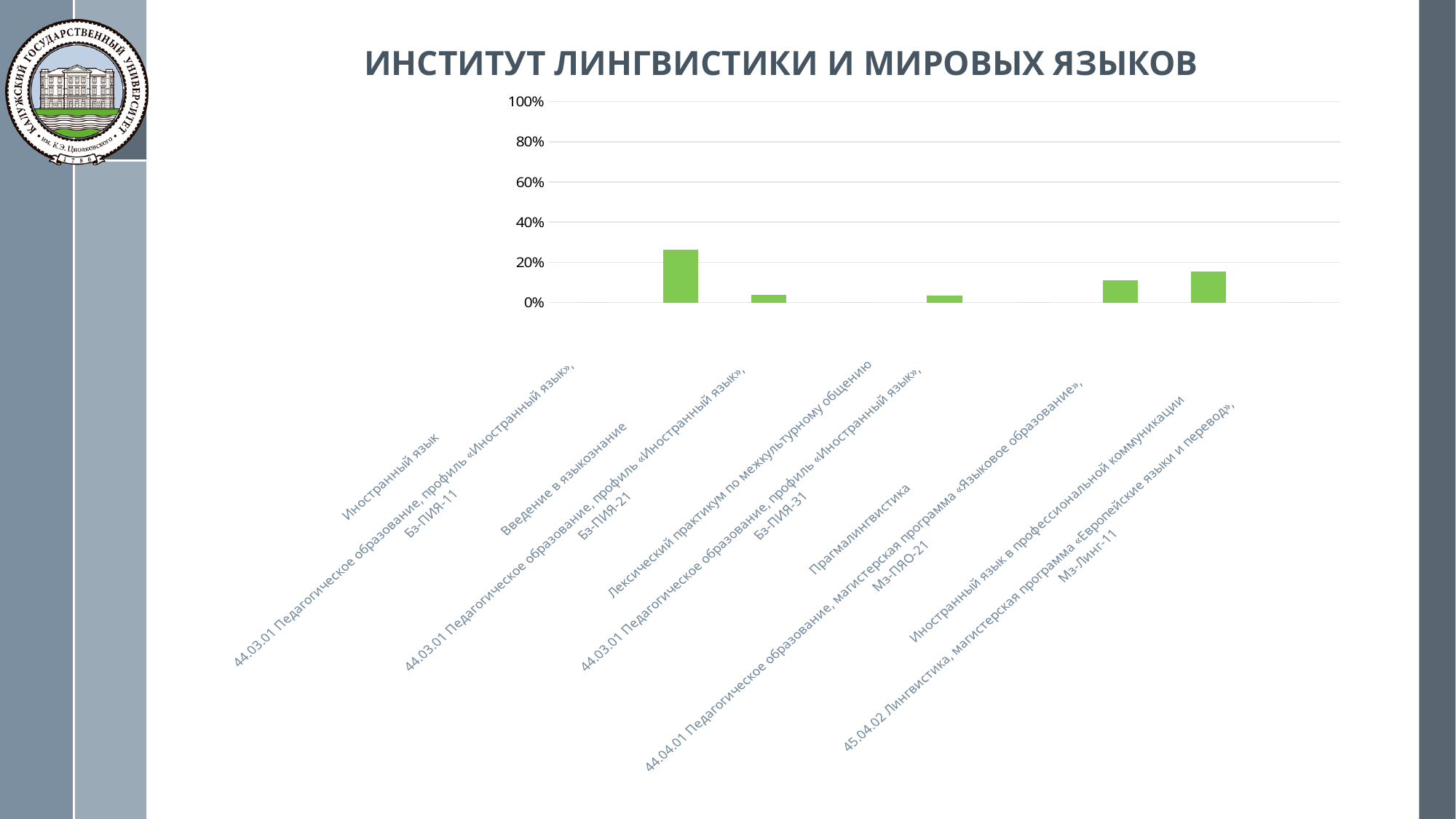
Is the value of the tallest bar in the chart greater or less than 40%? less How many bars are plotted in the chart? 5 Are any bars in the chart above the 60% gridline? No What is the title of the slide containing the chart? ИНСТИТУТ ЛИНГВИСТИКИ И МИРОВЫХ ЯЗЫКОВ Is the value of the rightmost bar in the chart greater or less than 20%? less What is the highest value shown on the vertical axis of the chart? 100% What colour are the bars in the chart? green What kind of chart is shown on the slide? bar chart Which bar is the tallest in the chart: the leftmost bar or the rightmost bar? the leftmost bar